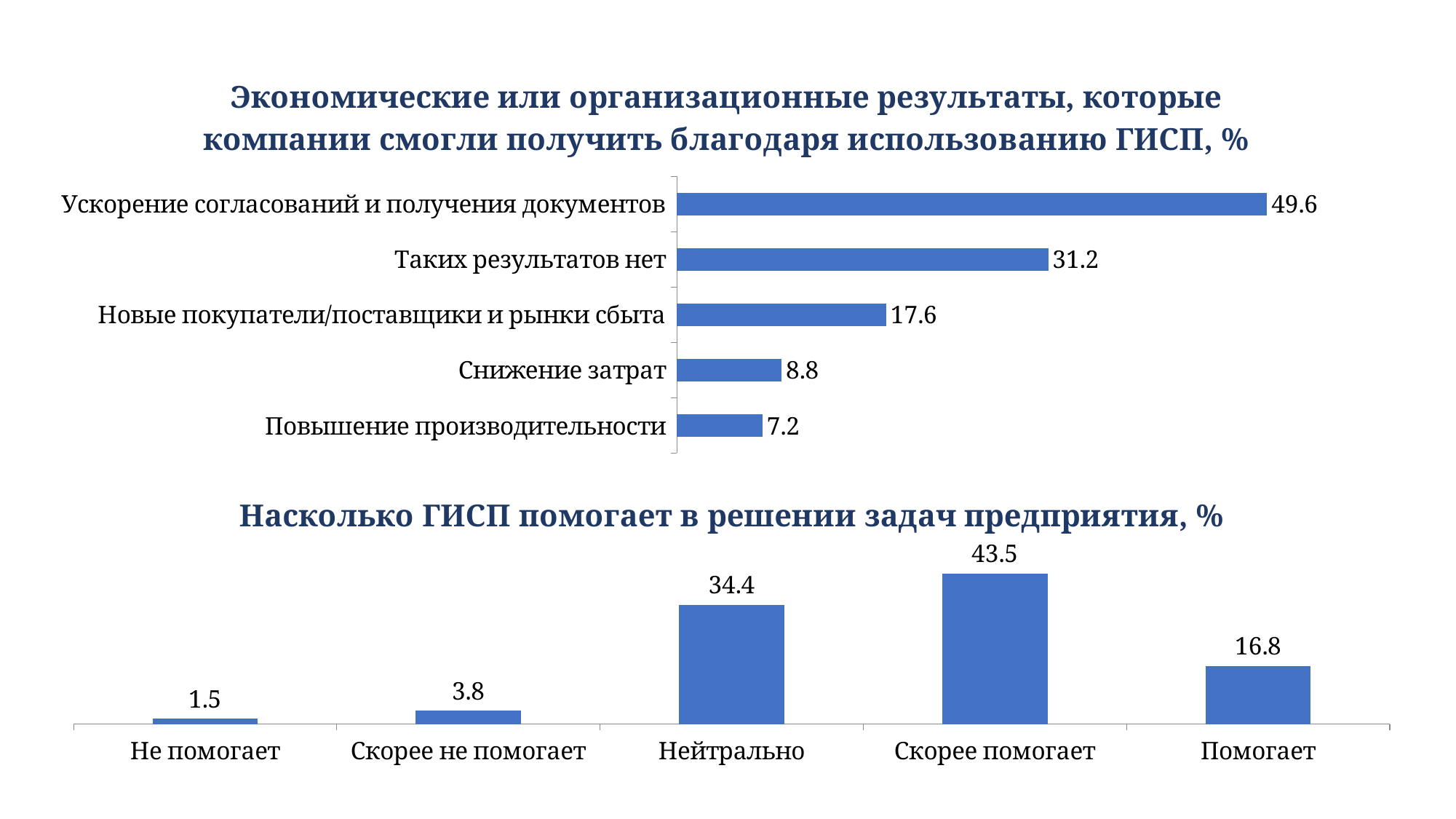
In the bottom chart, which category has the highest value? Скорее помогает In the bottom chart, which category has the lowest value? Не помогает What kind of chart is the top chart? Bar chart In the bottom chart (Насколько ГИСП помогает в решении задач предприятия), what is the value for 'Нейтрально'? 34.4 In the top chart, what is the value for 'Снижение затрат'? 8.8 In the bottom chart, how many categories are shown on the x axis? 5 In the top chart, which category has the lowest value? Повышение производительности In the bottom chart, which is larger: 'Помогает' or 'Скорее не помогает'? Помогает In the top chart, what is the difference between 'Таких результатов нет' and 'Новые покупатели/поставщики и рынки сбыта'? 13.6 In the top chart, how many categories are shown? 5 In the top chart (Экономические или организационные результаты...), what is the value for 'Ускорение согласований и получения документов'? 49.6 In the bottom chart, what is the difference between 'Скорее помогает' and 'Помогает'? 26.7